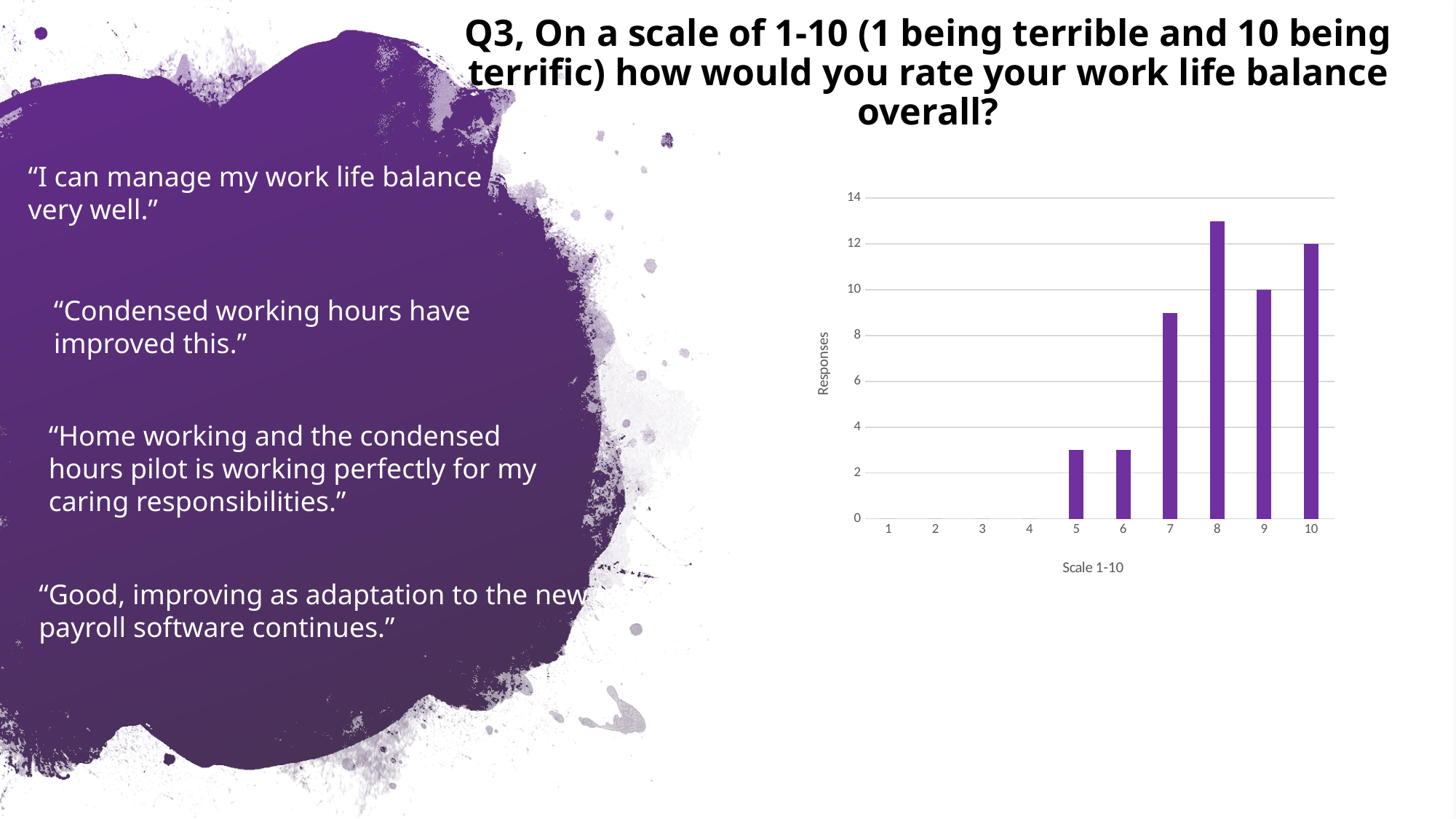
Is the number of responses for rating 8 greater or less than 12? greater How many responses are shown for a rating of 10? 12 What type of chart is shown on the slide? bar chart What is the difference in responses between rating 10 and rating 9? 2 How many rating categories are shown on the x axis? 10 How many responses are shown for a rating of 9? 10 Which rating on the scale received the most responses? 8 Is the number of responses for rating 7 greater or less than 8? greater Which rating has more responses, 8 or 9? 8 Which rating has more responses, 6 or 7? 7 What is the title of the vertical axis? Responses Is the number of responses for rating 5 greater or less than 4? less